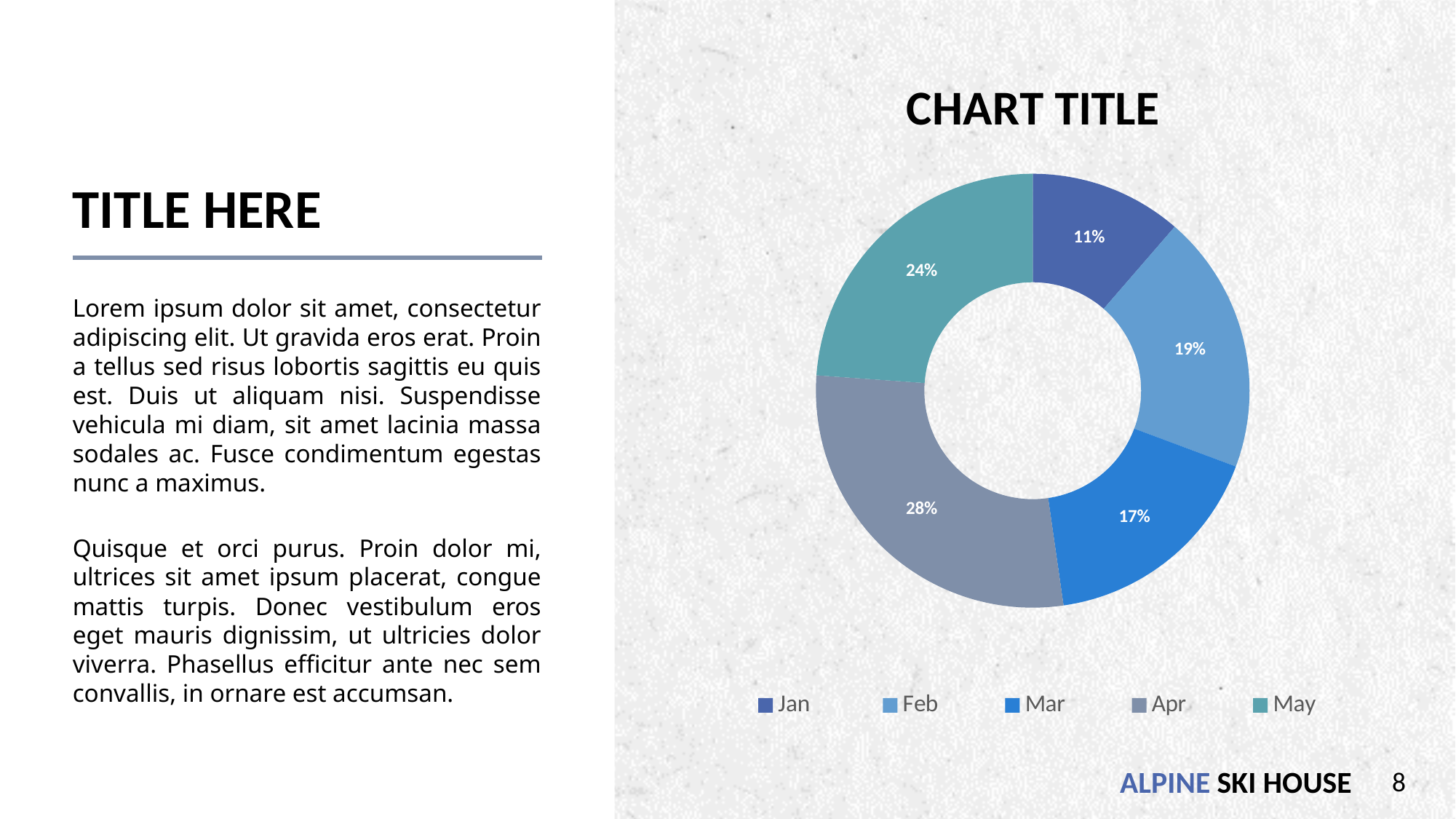
What share of the doughnut chart does May represent? 24% What share of the doughnut chart does Feb represent? 19% What is the title of the chart? CHART TITLE What type of chart is shown on the slide? Doughnut chart Which slice is larger, Feb or Mar? Feb How many categories are shown in the chart? 5 What share of the doughnut chart does Mar represent? 17% Which category has the smallest slice in the chart? Jan What share of the doughnut chart does Apr represent? 28% What share of the doughnut chart does Jan represent? 11% Which category has the largest slice in the chart? Apr What is the difference in percentage points between the Apr slice and the Jan slice? 17